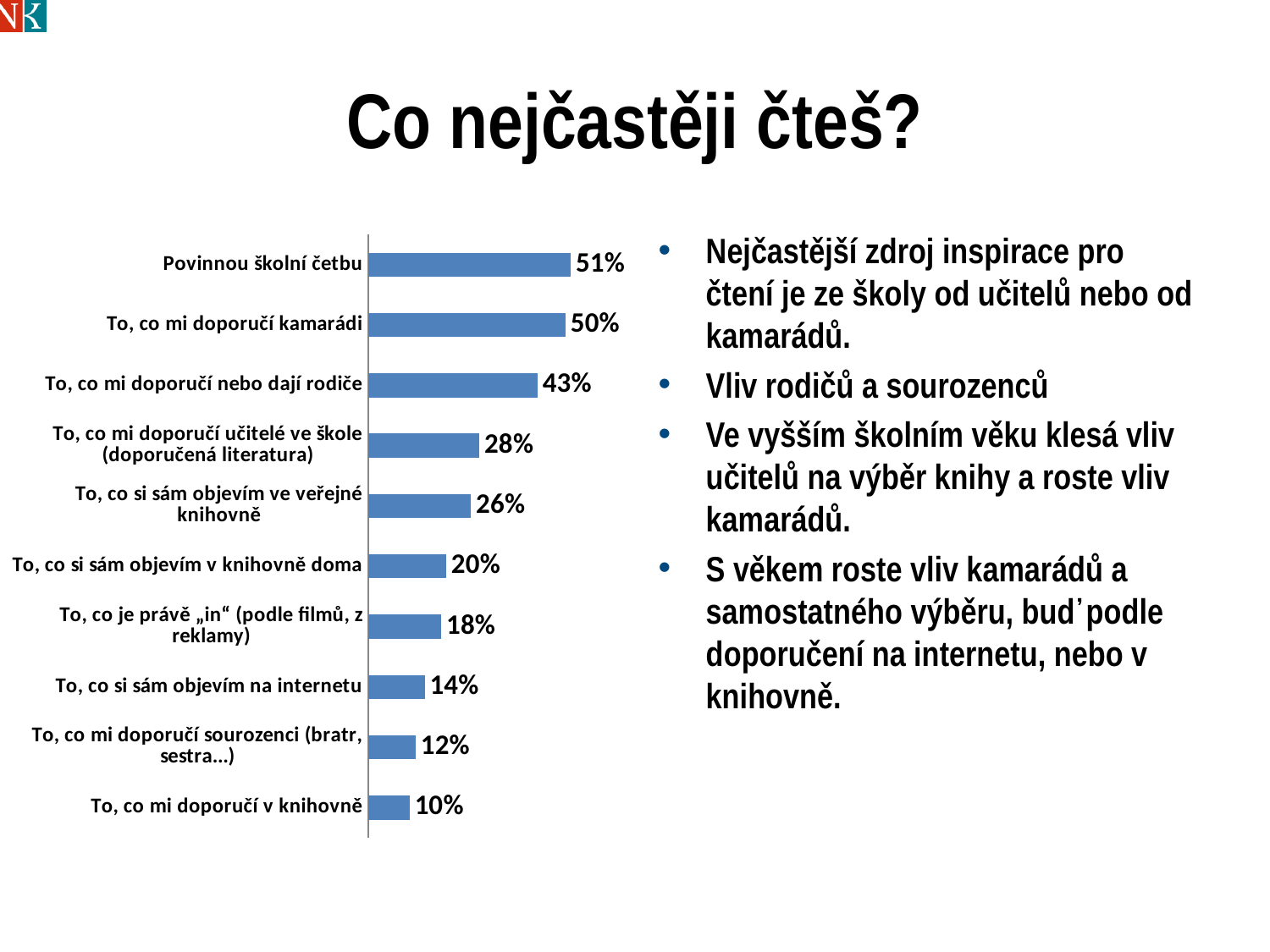
What value is shown for "To, co si sám objevím ve veřejné knihovně"? 26% What value is shown for "Povinnou školní četbu"? 51% What is the difference between the values for "To, co mi doporučí učitelé ve škole (doporučená literatura)" and "To, co si sám objevím v knihovně doma"? 8% What value is shown for "To, co mi doporučí sourozenci (bratr, sestra...)"? 12% What is the difference between the values for "To, co mi doporučí kamarádi" and "To, co mi doporučí nebo dají rodiče"? 7% How many categories are shown in the chart? 10 What is the title of the slide containing the chart? Co nejčastěji čteš? What kind of chart is shown on the slide? Bar chart Which is larger: the value for "To, co je právě „in“ (podle filmů, z reklamy)" or the value for "To, co si sám objevím na internetu"? To, co je právě „in“ (podle filmů, z reklamy) Which category has the highest value? Povinnou školní četbu What colour are the bars in the chart? Blue Which category has the lowest value? To, co mi doporučí v knihovně